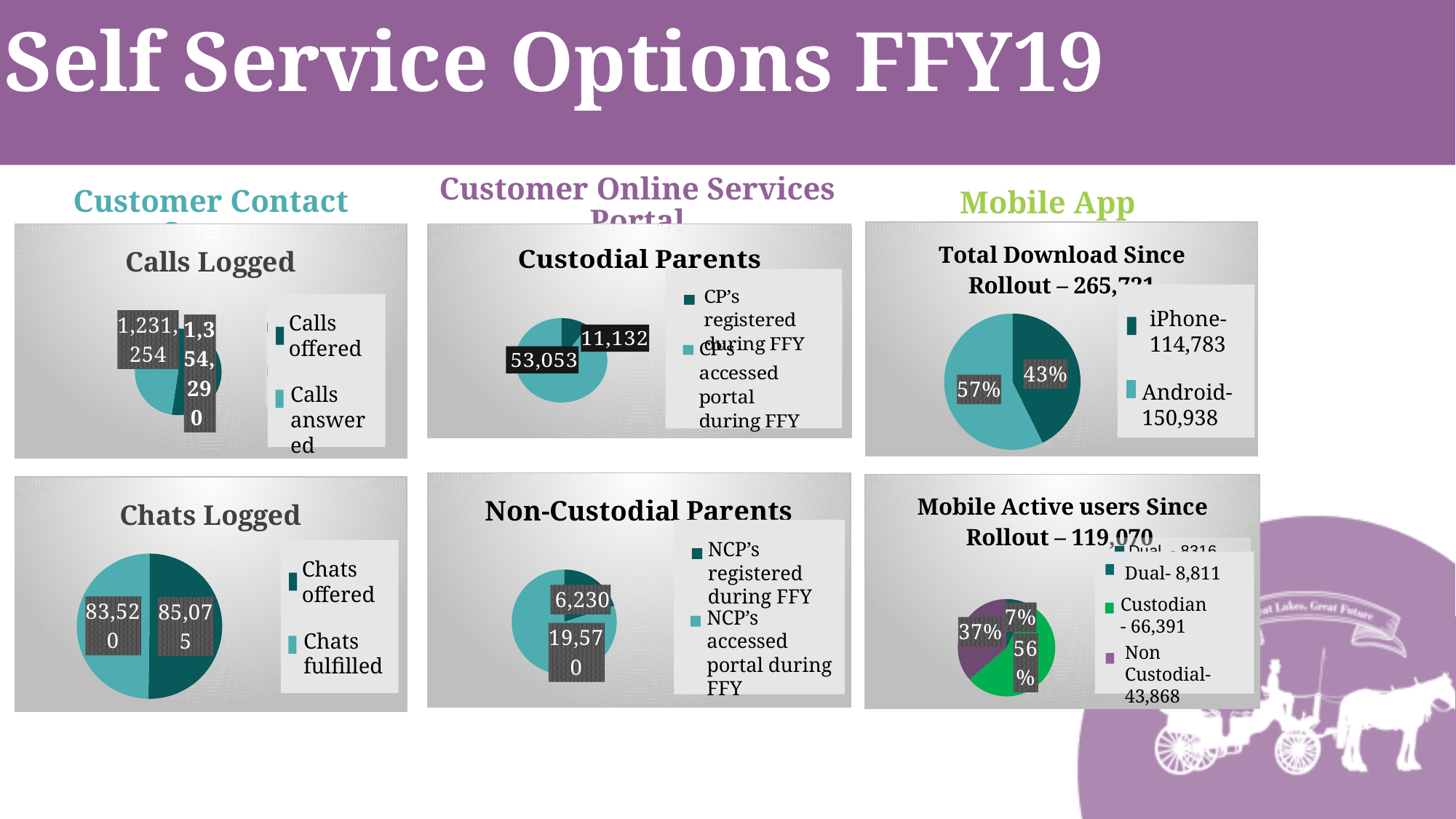
In the Mobile Active users Since Rollout chart, which category is the smallest? Dual In the Total Download Since Rollout chart, what share of downloads is Android? 57% In the Total Download Since Rollout chart, what is the value for iPhone? 114,783 In the Non-Custodial Parents chart, which is larger: NCP's registered during FFY or NCP's accessed portal during FFY? NCP's accessed portal during FFY In the Custodial Parents chart, how many CP's registered during FFY? 11,132 In the Mobile Active users Since Rollout chart, what share of active users is Custodian? 56% In the Chats Logged chart, what is the value for Chats fulfilled? 83,520 In the Custodial Parents chart, how many CP's accessed the portal during FFY? 53,053 In the Non-Custodial Parents chart, what is the difference between NCP's accessed portal during FFY and NCP's registered during FFY? 13,340 In the Chats Logged chart, what is the difference between Chats offered and Chats fulfilled? 1,555 In the Chats Logged chart, what is the value for Chats offered? 85,075 How many series does the legend of the Mobile Active users Since Rollout chart list? 3